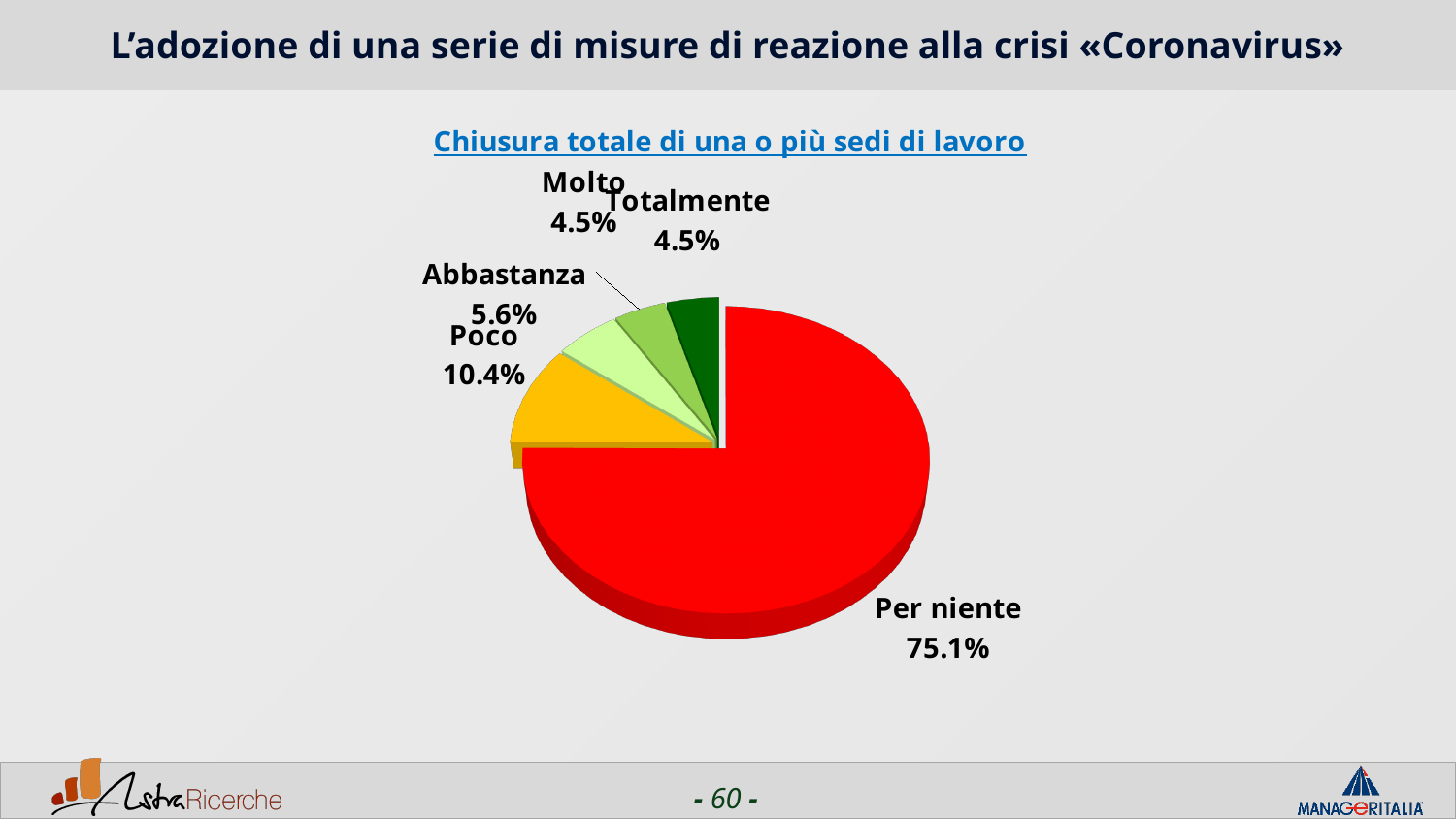
What is the title of the chart? Chiusura totale di una o più sedi di lavoro What kind of chart is shown on the slide? Pie chart What is the value for "Totalmente"? 4.5% What is the value for "Poco"? 10.4% What is the value for "Molto"? 4.5% How many slices does the pie chart have? 5 Which is larger, the value for "Poco" or the value for "Abbastanza"? Poco What is the difference between the values for "Per niente" and "Poco"? 64.7% Which category has the largest slice? Per niente What is the value for "Per niente"? 75.1% What is the value for "Abbastanza"? 5.6% What colour is the "Per niente" slice? Red